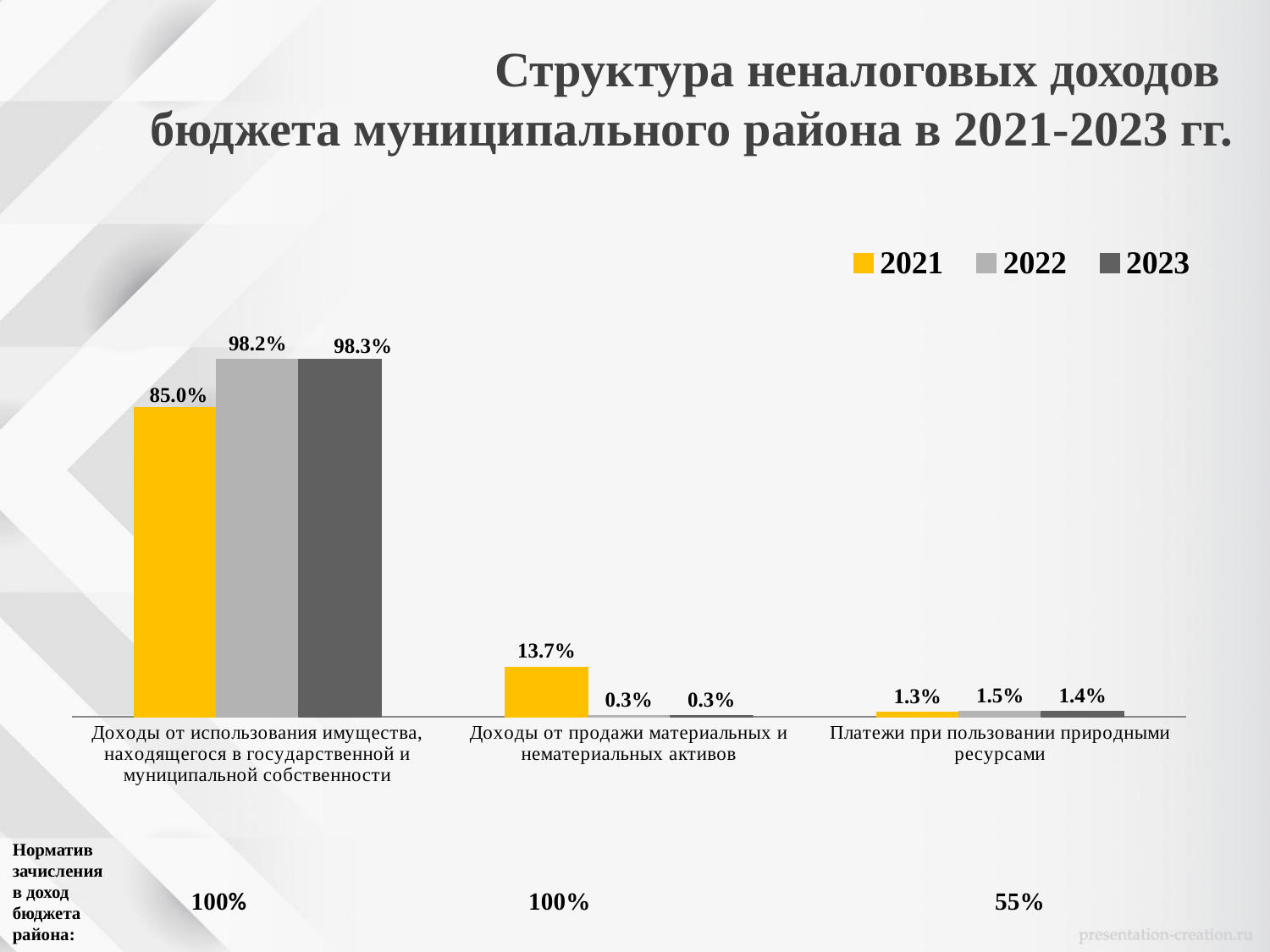
How many series does the legend list? 3 What is the difference between the 2021 and 2022 values in the category 'Доходы от продажи материальных и нематериальных активов'? 13.4% Which year has the lowest value in the category 'Платежи при пользовании природными ресурсами'? 2021 How many categories are shown on the x axis of the chart? 3 What is the value for 2021 in the category 'Доходы от использования имущества, находящегося в государственной и муниципальной собственности'? 85.0% What is the value for 2023 in the category 'Доходы от продажи материальных и нематериальных активов'? 0.3% Which is larger: the 2021 value for 'Доходы от продажи материальных и нематериальных активов' or the 2021 value for 'Платежи при пользовании природными ресурсами'? Доходы от продажи материальных и нематериальных активов What kind of chart is shown on the slide? Bar chart What is the difference between the 2022 and 2021 values in the category 'Доходы от использования имущества, находящегося в государственной и муниципальной собственности'? 13.2% What is the value for 2021 in the category 'Доходы от продажи материальных и нематериальных активов'? 13.7% Which year has the highest value in the category 'Доходы от использования имущества, находящегося в государственной и муниципальной собственности'? 2023 What is the value for 2022 in the category 'Платежи при пользовании природными ресурсами'? 1.5%